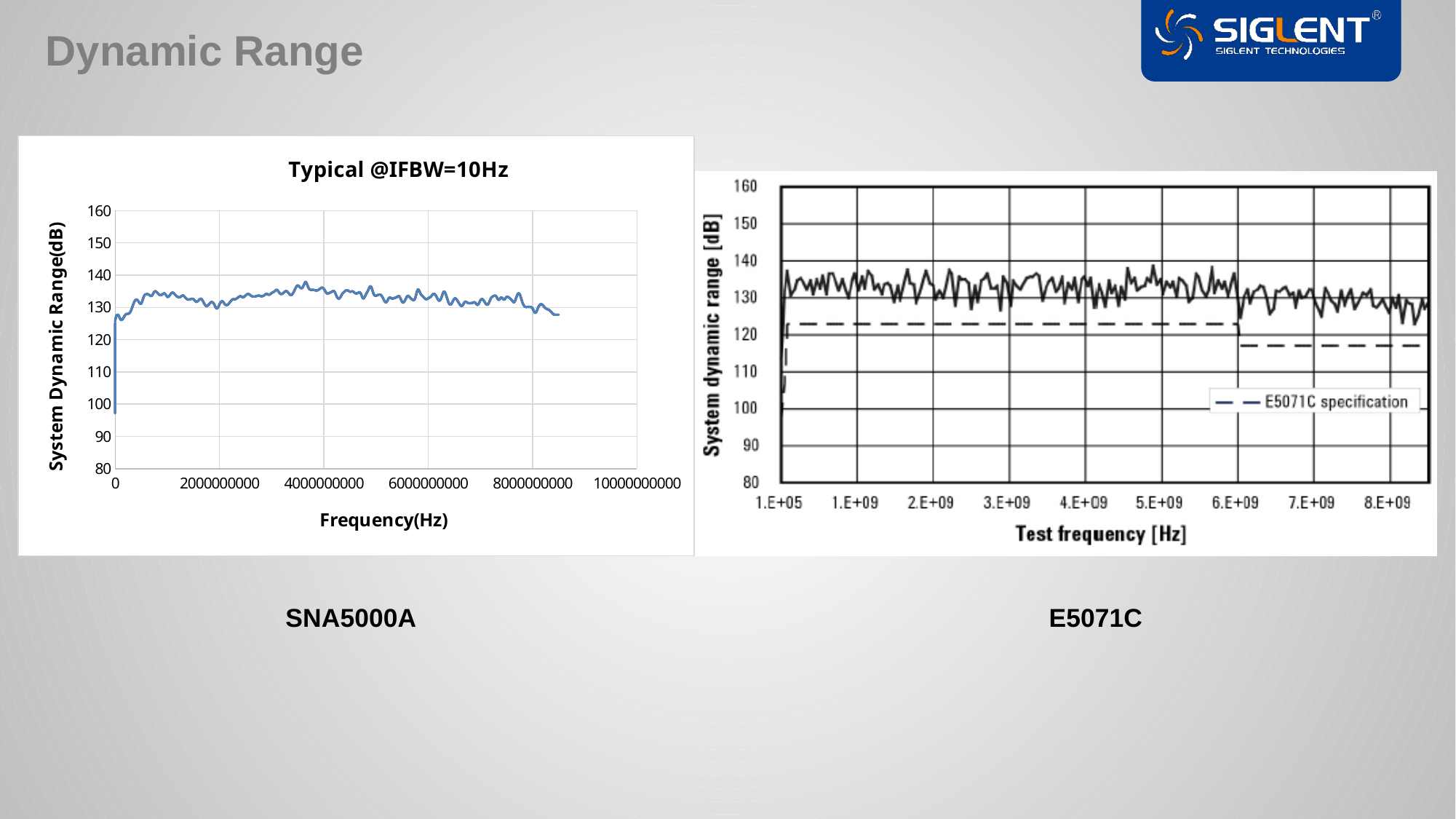
What kind of chart is the right chart (E5071C)? line chart In the left chart titled "Typical @IFBW=10Hz", is the value at 8000000000 Hz greater or less than 140? less What is the title of the left chart? Typical @IFBW=10Hz In the right chart (E5071C), is the E5071C specification line at 3.E+09 Hz greater or less than 130? less In the left chart titled "Typical @IFBW=10Hz", is the value at 2000000000 Hz greater or less than 110? greater What kind of chart is the left chart titled "Typical @IFBW=10Hz"? line chart How many entries does the legend of the right chart (E5071C) list? 1 What is the x-axis label of the right chart (E5071C)? Test frequency [Hz]